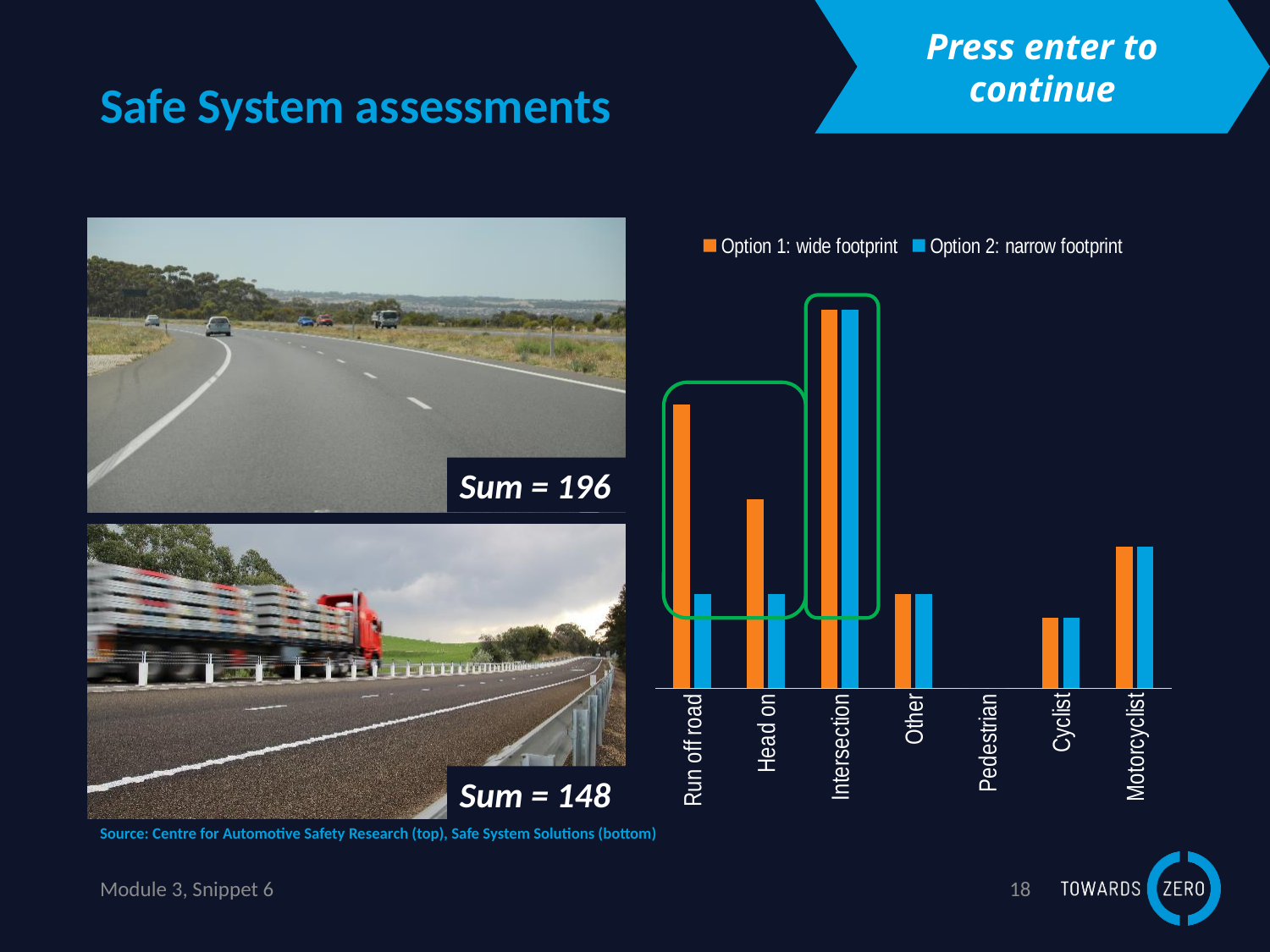
What colour represents Option 2: narrow footprint in the chart? Blue How many series does the chart's legend list? 2 Which has the larger Option 2: narrow footprint value: Cyclist or Motorcyclist? Motorcyclist Which category has the highest value for Option 2: narrow footprint? Intersection Which category has the highest value for Option 1: wide footprint? Intersection How many categories are shown on the x axis of the chart? 7 Which category shows no visible bars in the chart? Pedestrian Which has the larger Option 1: wide footprint value: Run off road or Head on? Run off road For Run off road, which is larger: Option 1: wide footprint or Option 2: narrow footprint? Option 1: wide footprint What kind of chart is shown on the slide? Bar chart